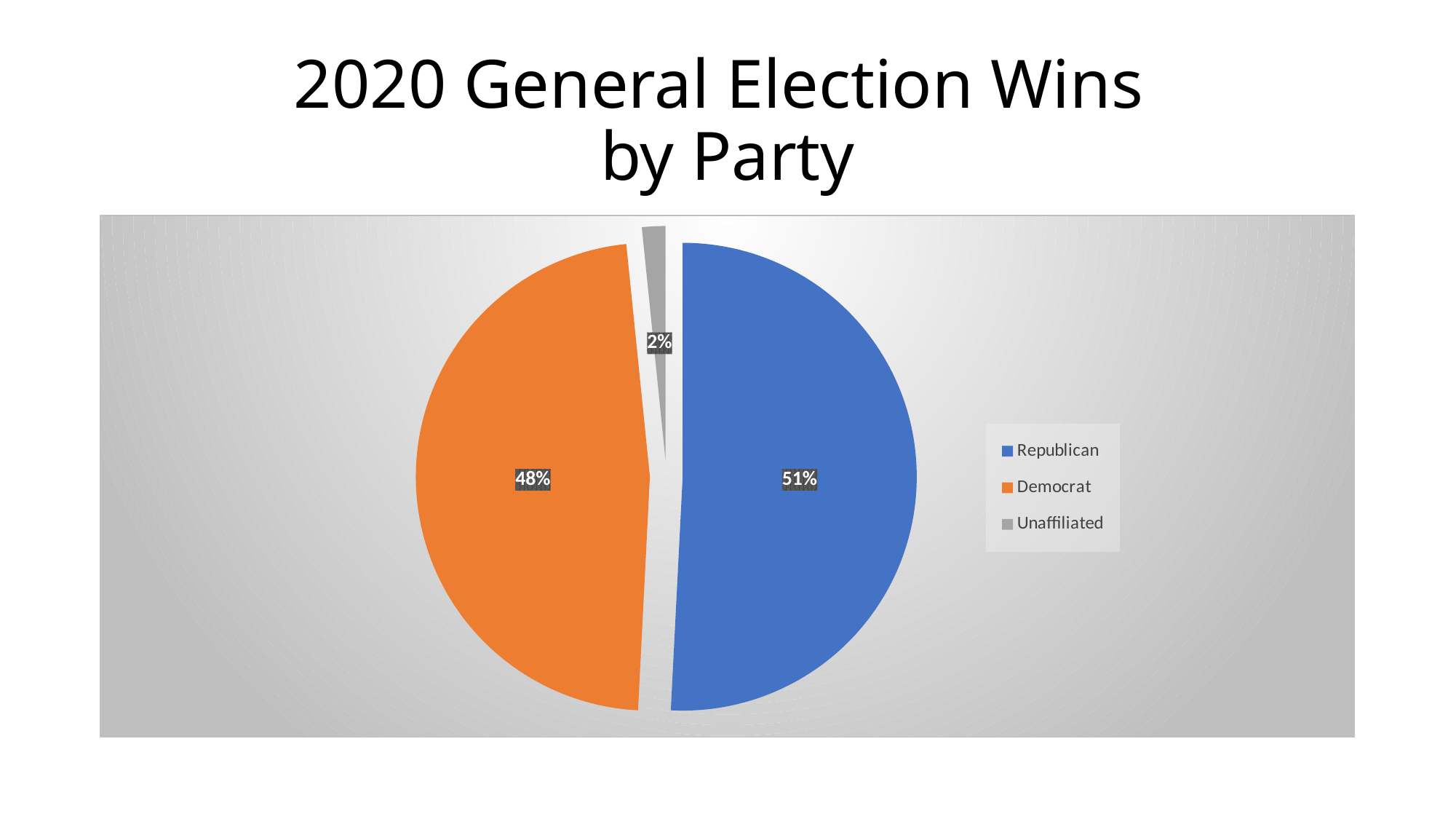
What share of the pie does Democrat have? 48% What share of the pie does Republican have? 51% Which slice is larger, Republican or Democrat? Republican What colour is the Democrat slice? Orange How many slices does the pie chart have? 3 What is the difference in percentage points between the Democrat and Unaffiliated slices? 46 What is the difference in percentage points between the Republican and Democrat slices? 3 What share of the pie does Unaffiliated have? 2% Which party has the largest slice of the pie? Republican Which party has the smallest slice of the pie? Unaffiliated What kind of chart is shown on the slide? Pie chart What is the title of the slide? 2020 General Election Wins by Party